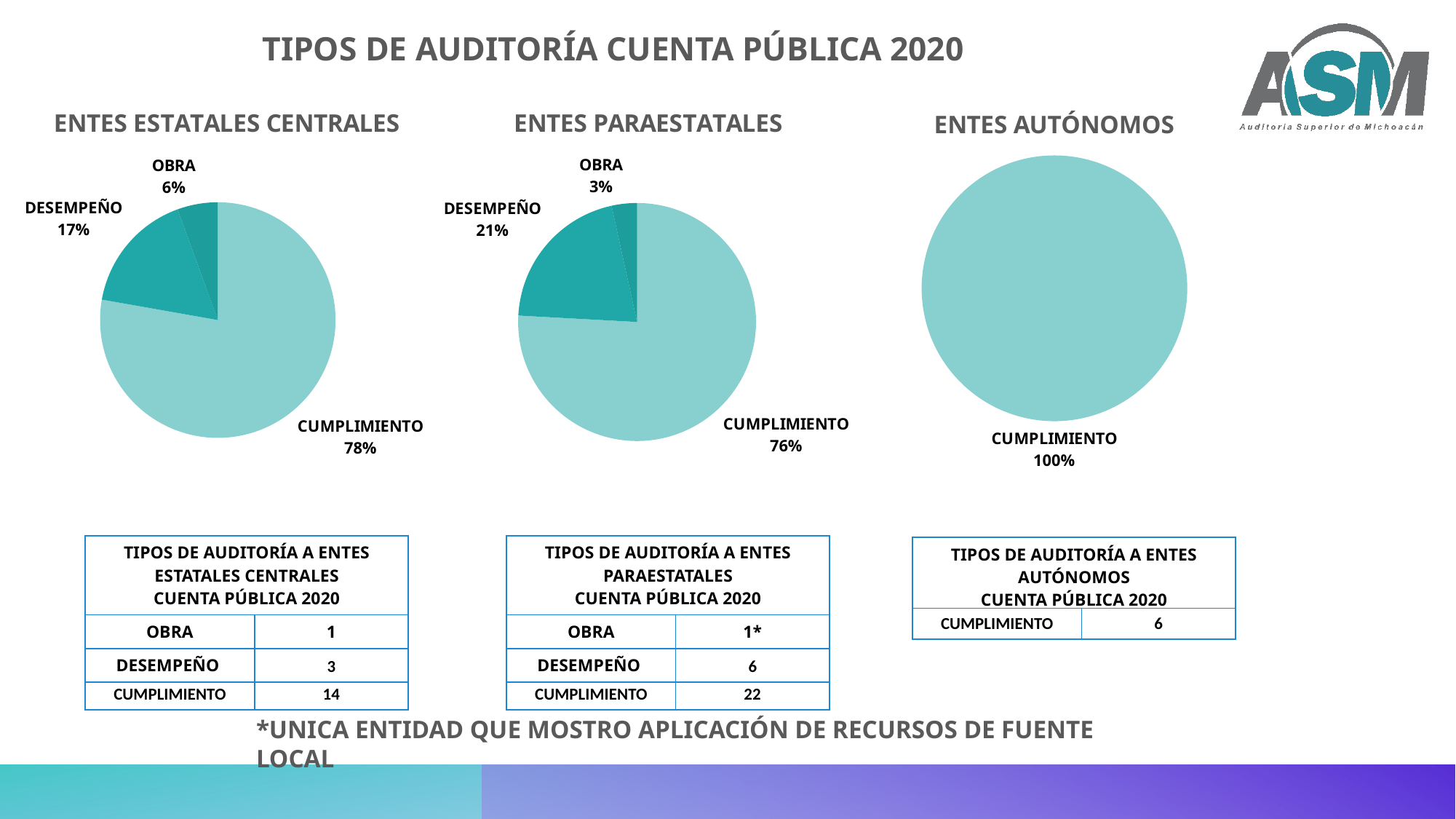
What is the title of the slide containing the three pie charts? TIPOS DE AUDITORÍA CUENTA PÚBLICA 2020 In the ENTES ESTATALES CENTRALES pie chart, which category has the smallest slice? OBRA How many categories does the ENTES ESTATALES CENTRALES pie chart show? 3 In the ENTES ESTATALES CENTRALES pie chart, what share does CUMPLIMIENTO have? 78% In the ENTES PARAESTATALES pie chart, what is the difference between the CUMPLIMIENTO and DESEMPEÑO shares? 55% In the ENTES ESTATALES CENTRALES pie chart, what share does DESEMPEÑO have? 17% In the ENTES PARAESTATALES pie chart, which category has the largest slice? CUMPLIMIENTO Which is larger: the DESEMPEÑO share in the ENTES ESTATALES CENTRALES chart or the DESEMPEÑO share in the ENTES PARAESTATALES chart? ENTES PARAESTATALES In the ENTES AUTÓNOMOS pie chart, what share does CUMPLIMIENTO have? 100% How many slices does the ENTES AUTÓNOMOS pie chart have? 1 What kind of chart is used for ENTES PARAESTATALES? Pie chart